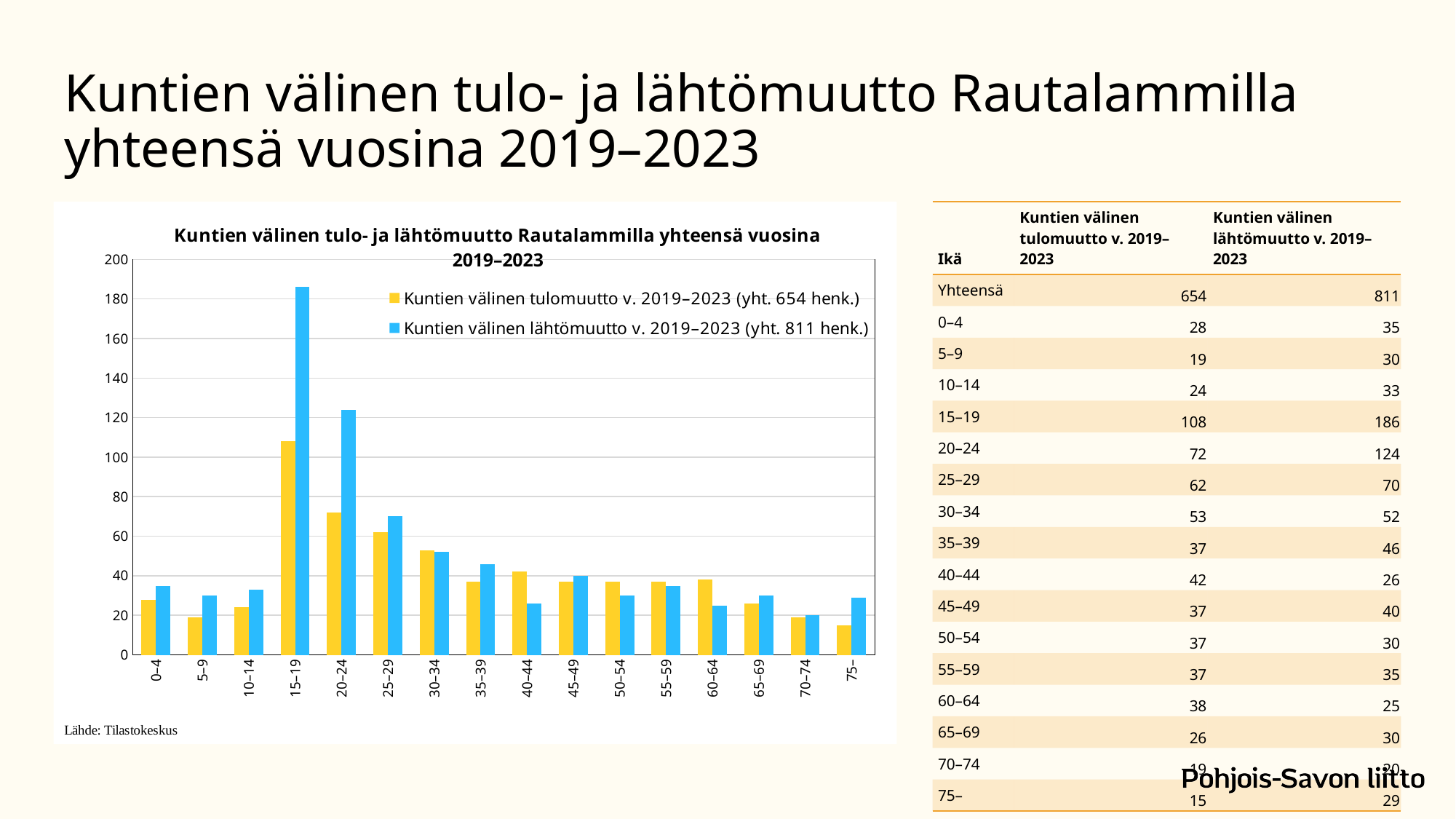
Do the lähtömuutto values rise or fall along the x axis from 15–19 to 40–44? fall Is the value of lähtömuutto for the 20–24 age group greater or less than 100? greater According to the legend, what is the total number of persons for Kuntien välinen lähtömuutto v. 2019–2023? 811 henk. What is the value of Kuntien välinen tulomuutto v. 2019–2023 for the 20–24 age group? 72 What is the difference between lähtömuutto and tulomuutto for the 15–19 age group? 78 How many series does the chart legend list? 2 For the 40–44 age group, which is larger: tulomuutto or lähtömuutto? tulomuutto Which age group has the highest value for Kuntien välinen lähtömuutto v. 2019–2023? 15–19 What is the value of Kuntien välinen lähtömuutto v. 2019–2023 for the 15–19 age group? 186 Which age group has the lowest value for Kuntien välinen tulomuutto v. 2019–2023? 75– What kind of chart is shown on the slide? bar chart How many age groups are shown on the x axis of the chart? 16